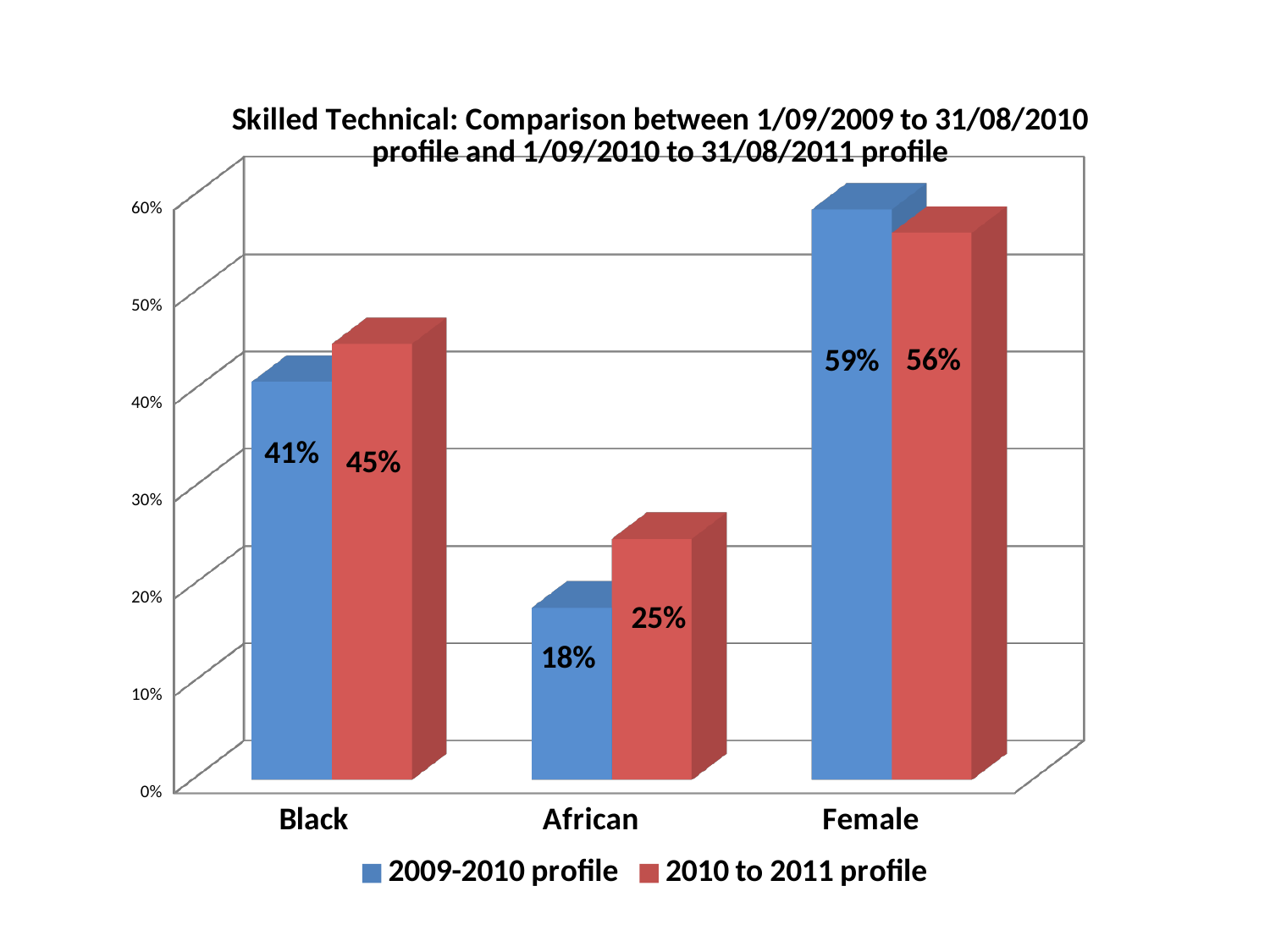
How many categories are shown on the x axis? 3 How many series does the legend list? 2 What is the value for Black in the 2009-2010 profile series? 41% Which colour represents the 2010 to 2011 profile series? Red What kind of chart is shown on the slide? Bar chart Which category has the highest value in the 2010 to 2011 profile series? Female Which category has the lowest value in the 2009-2010 profile series? African For Black, which series has the larger value: 2009-2010 profile or 2010 to 2011 profile? 2010 to 2011 profile What is the value for Female in the 2009-2010 profile series? 59% What is the difference between the 2009-2010 profile and 2010 to 2011 profile values for Female? 3% What is the value for African in the 2010 to 2011 profile series? 25% What is the difference between the 2010 to 2011 profile and 2009-2010 profile values for African? 7%